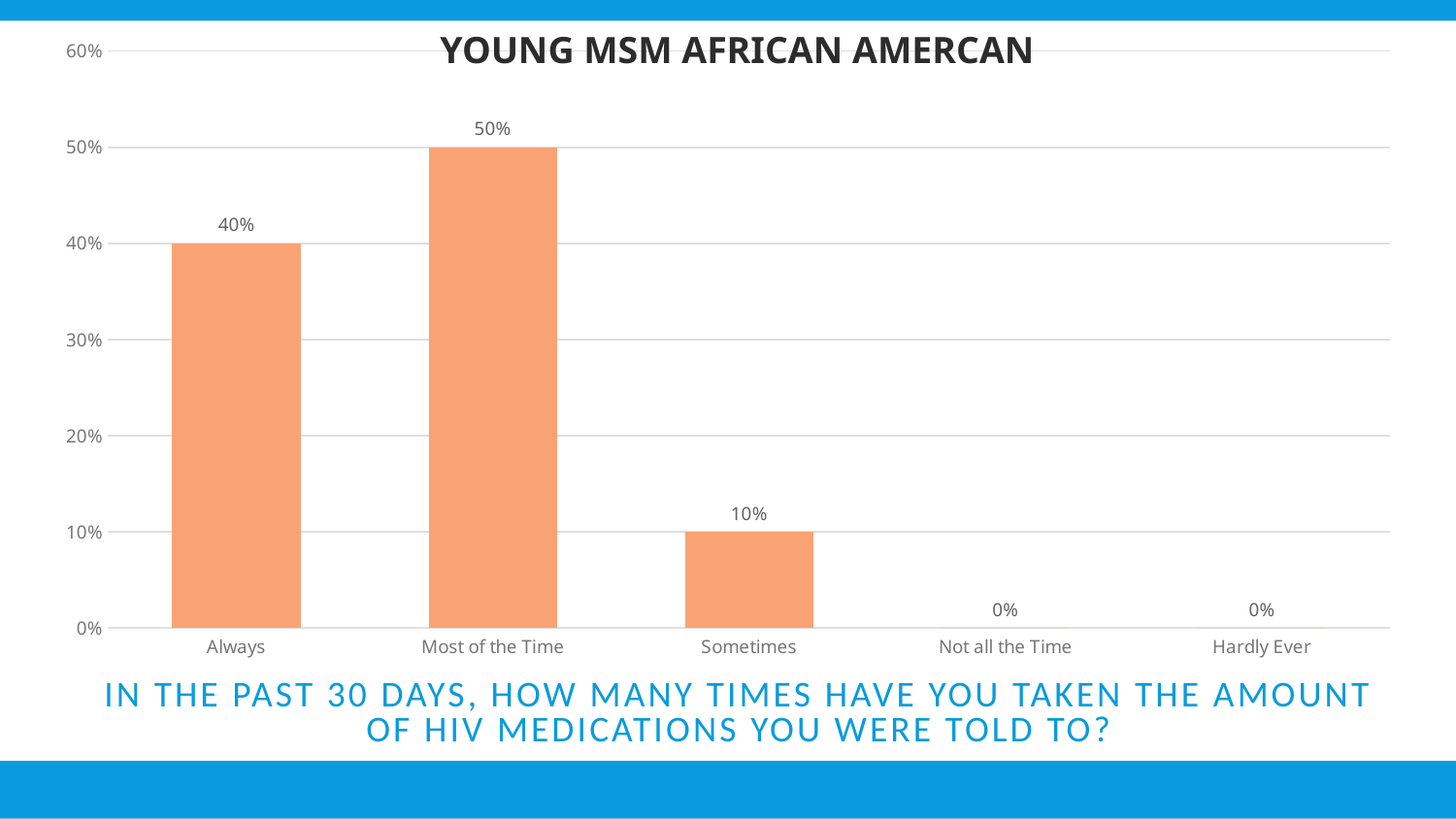
Which category has the highest value? Most of the Time What is the value for "Hardly Ever"? 0% What is the difference between the values for "Always" and "Sometimes"? 30% Is the value for "Sometimes" greater or less than 20%? less What kind of chart is shown on the slide? bar chart What is the value for "Sometimes"? 10% What is the difference between the values for "Most of the Time" and "Always"? 10% Which is larger, the value for "Always" or the value for "Sometimes"? Always How many categories are shown on the x axis? 5 What is the value for "Always"? 40% What is the value for "Most of the Time"? 50% What is the title of the chart? YOUNG MSM AFRICAN AMERCAN